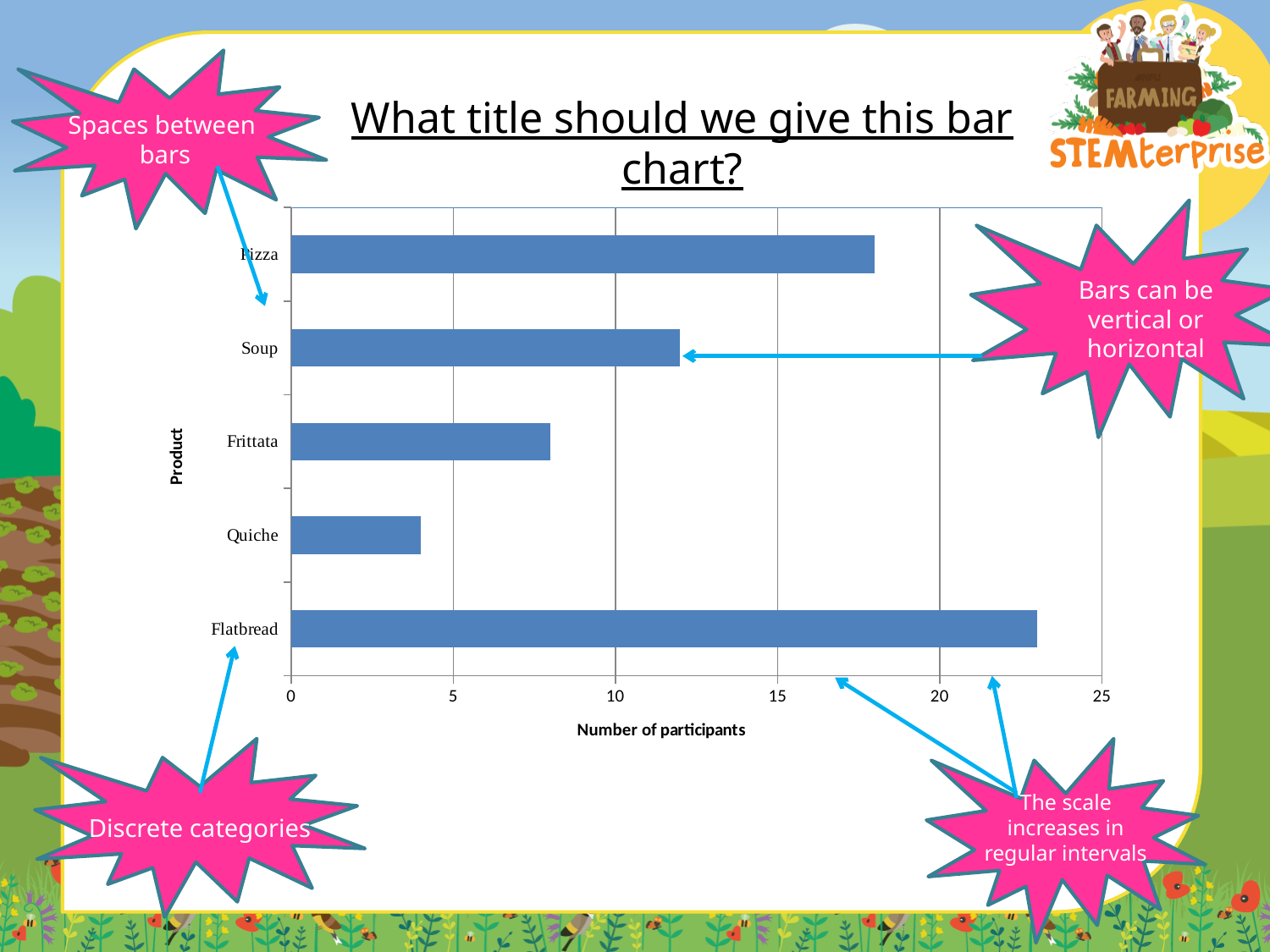
What kind of chart is shown on the slide? bar chart Is the number of participants for Soup greater or less than 10? greater Is the number of participants for Pizza greater or less than 15? greater Is the number of participants for Flatbread greater or less than 20? greater Which product has the highest number of participants? Flatbread What is the label on the vertical axis of the chart? Product What is the label on the horizontal axis of the chart? Number of participants How many products are shown on the chart? 5 Which has more participants, Pizza or Soup? Pizza Which product has the lowest number of participants? Quiche